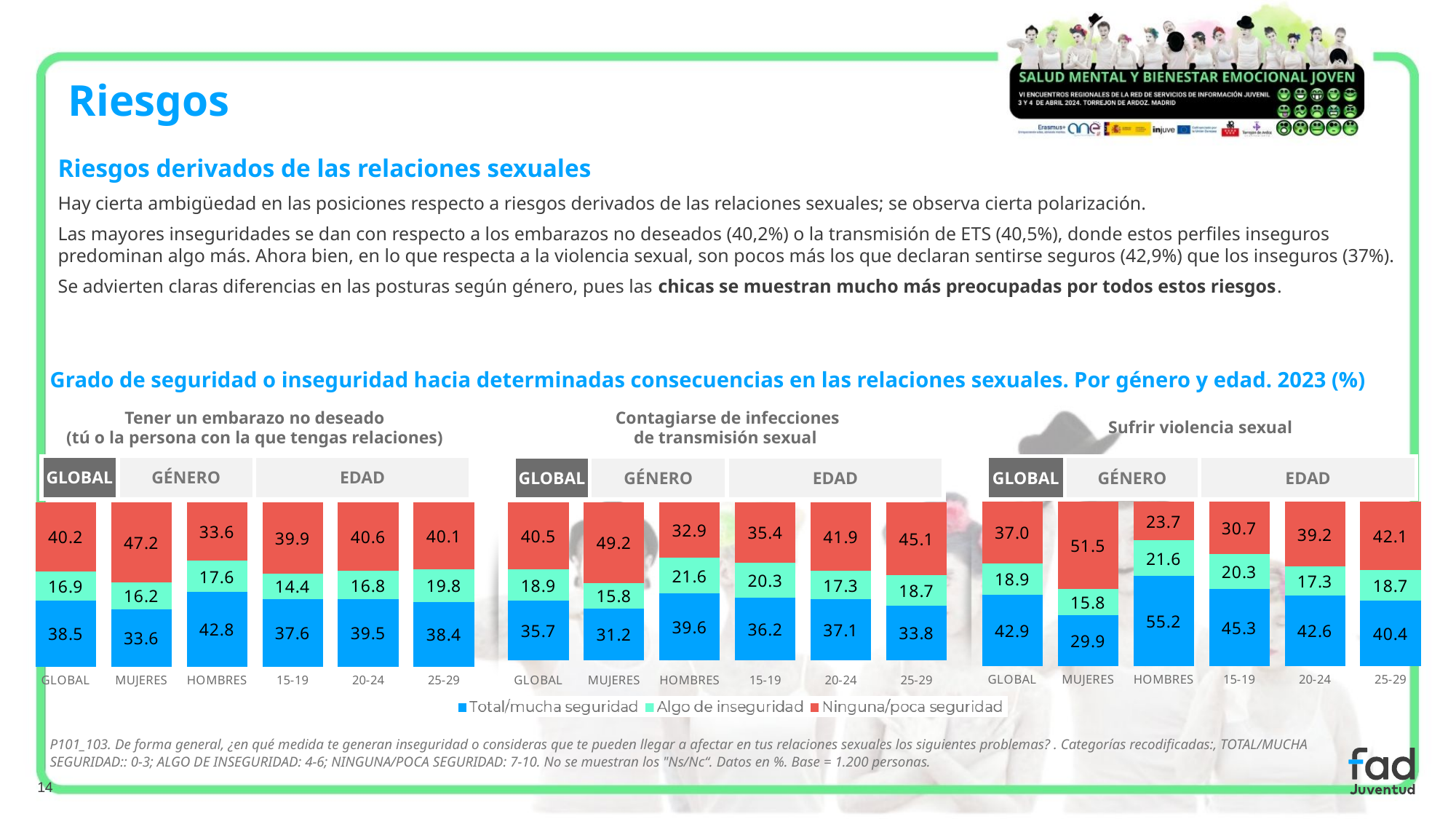
Which colour represents 'Ninguna/poca seguridad' in the charts? Red In the 'Contagiarse de infecciones de transmisión sexual' chart, what is the total of the stacked bar for HOMBRES? 94.1 In the 'Contagiarse de infecciones de transmisión sexual' chart, what is the value of 'Algo de inseguridad' for GLOBAL? 18.9 In the 'Tener un embarazo no deseado' chart, what is the value of 'Ninguna/poca seguridad' for MUJERES? 47.2 How many series does the legend list for the charts? 3 In the 'Sufrir violencia sexual' chart, which is larger for 25-29: 'Total/mucha seguridad' or 'Ninguna/poca seguridad'? Ninguna/poca seguridad In the 'Contagiarse de infecciones de transmisión sexual' chart, which category has the lowest value for 'Total/mucha seguridad'? MUJERES What kind of chart is the 'Sufrir violencia sexual' chart? Stacked bar chart How many categories are shown on the x axis of the 'Contagiarse de infecciones de transmisión sexual' chart? 6 In the 'Tener un embarazo no deseado' chart, what is the difference between the 'Total/mucha seguridad' values for HOMBRES and MUJERES? 9.2 In the 'Sufrir violencia sexual' chart, what is the value of 'Total/mucha seguridad' for HOMBRES? 55.2 In the 'Sufrir violencia sexual' chart, which category has the highest value for 'Ninguna/poca seguridad'? MUJERES